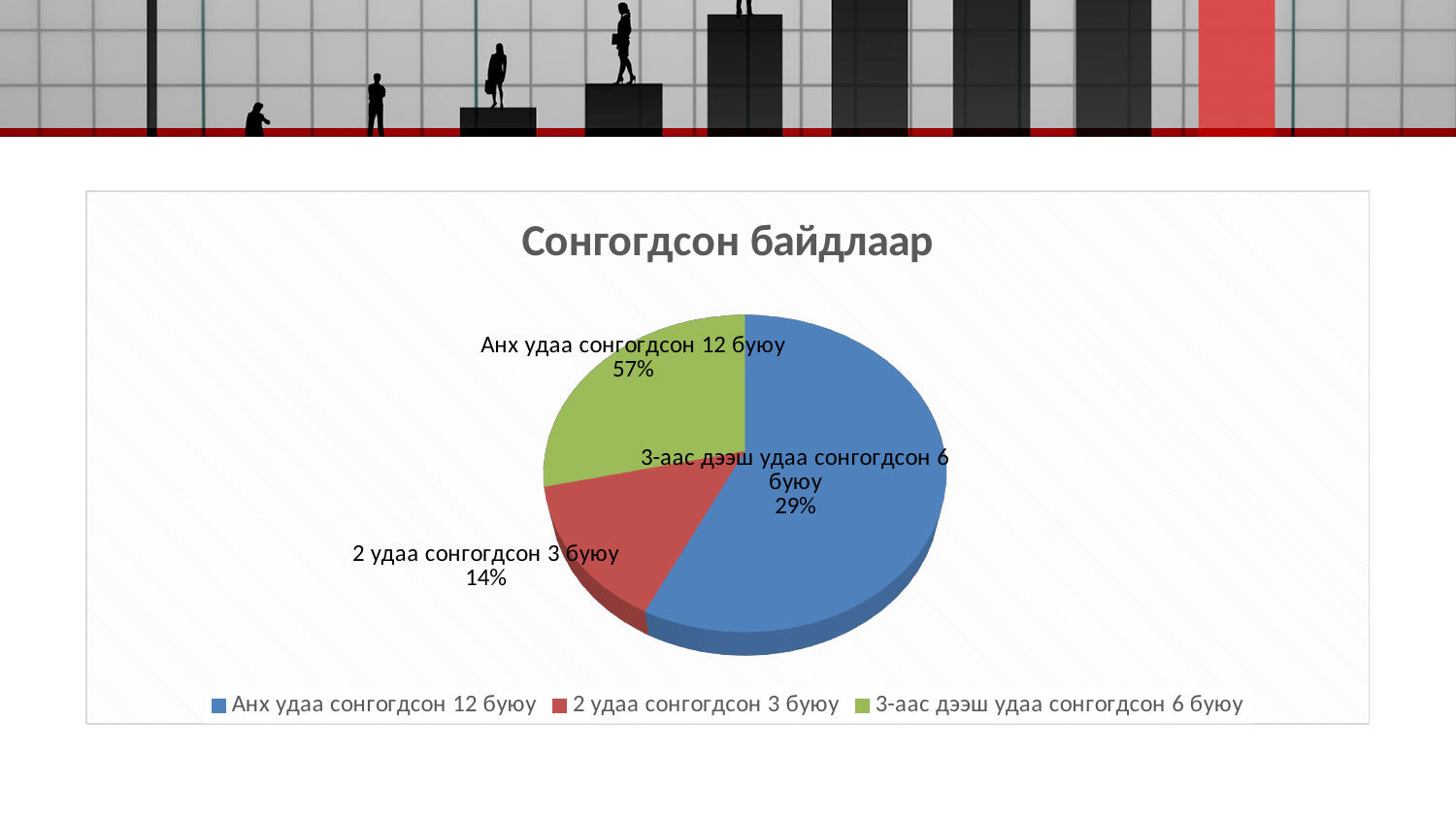
What kind of chart is shown on the slide? pie chart Which is larger: the share for "2 удаа сонгогдсон 3 буюу" or the share for "3-аас дээш удаа сонгогдсон 6 буюу"? 3-аас дээш удаа сонгогдсон 6 буюу What share of the pie is labelled "2 удаа сонгогдсон 3 буюу"? 14% What share of the pie is labelled "Анх удаа сонгогдсон 12 буюу"? 57% What colour is the slice for "2 удаа сонгогдсон 3 буюу" according to the legend? red What share of the pie is labelled "3-аас дээш удаа сонгогдсон 6 буюу"? 29% Which category has the largest share of the pie? Анх удаа сонгогдсон 12 буюу How many slices does the pie chart have? 3 Which category has the smallest share of the pie? 2 удаа сонгогдсон 3 буюу What is the title of the chart? Сонгогдсон байдлаар What is the difference in percentage points between "Анх удаа сонгогдсон 12 буюу" and "3-аас дээш удаа сонгогдсон 6 буюу"? 28 How many entries does the legend list? 3